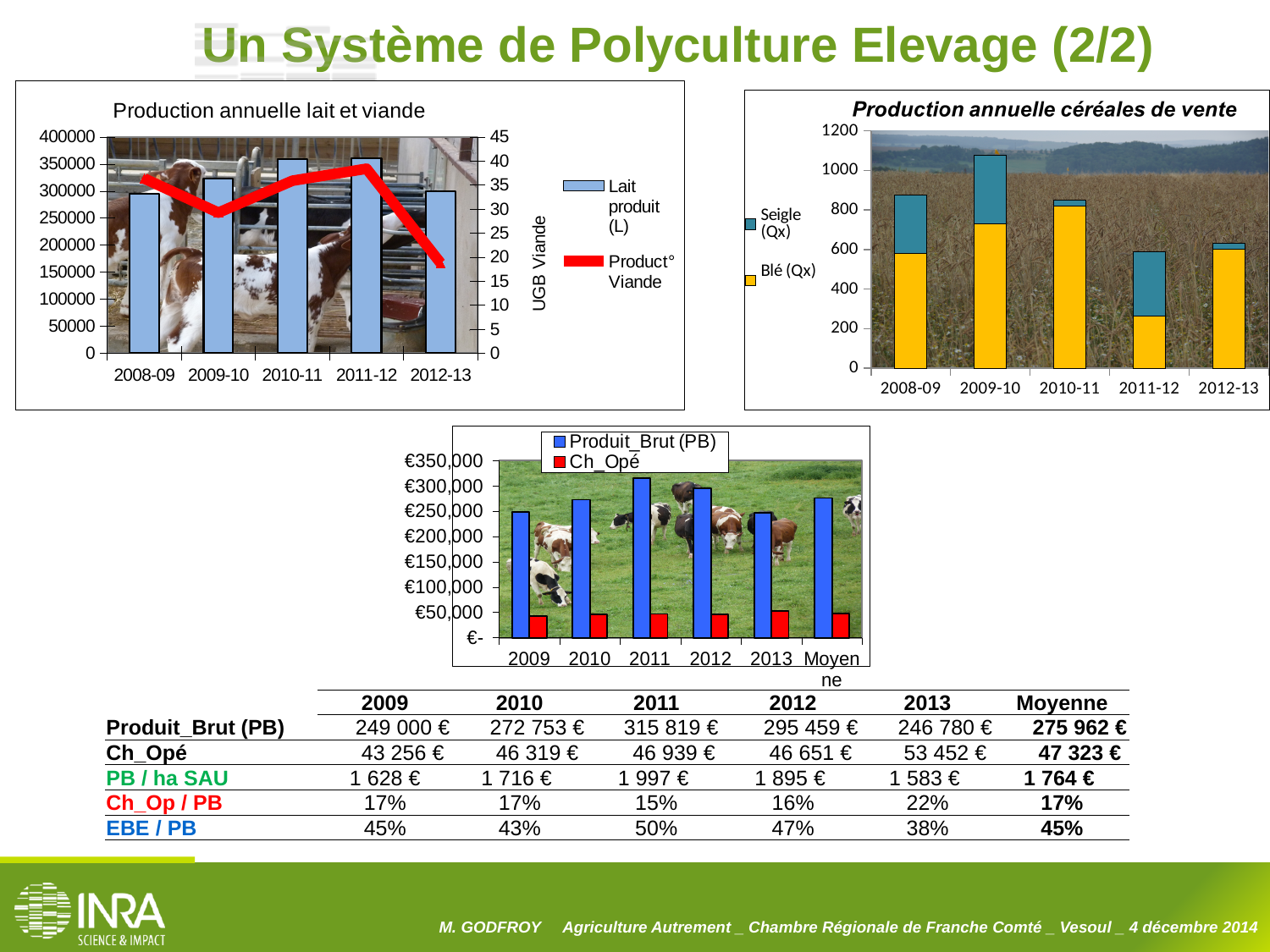
In 'Production annuelle lait et viande', is the Product° Viande value for 2012-13 greater or less than 25 UGB Viande? less In 'Production annuelle céréales de vente', which is larger, the Blé (Qx) value for 2010-11 or for 2008-09? 2010-11 In 'Production annuelle céréales de vente', is the Blé (Qx) value for 2011-12 greater or less than 400? less In 'Production annuelle lait et viande', which year has the lowest Product° Viande value? 2012-13 What are the two series listed in the legend of 'Production annuelle céréales de vente'? Seigle (Qx) and Blé (Qx) In 'Production annuelle lait et viande', is the Lait produit (L) value for 2010-11 greater or less than 350000? greater In the bottom chart with Produit_Brut (PB) and Ch_Opé, which category has the highest Produit_Brut (PB) bar? 2011 How many categories are shown on the x axis of the bottom chart with Produit_Brut (PB) and Ch_Opé? 6 How many years are shown on the x axis of 'Production annuelle céréales de vente'? 5 In 'Production annuelle céréales de vente', which year has the highest total stacked bar? 2009-10 How many series does the legend of 'Production annuelle lait et viande' list? 2 What kind of chart is 'Production annuelle lait et viande'? bar chart with a line